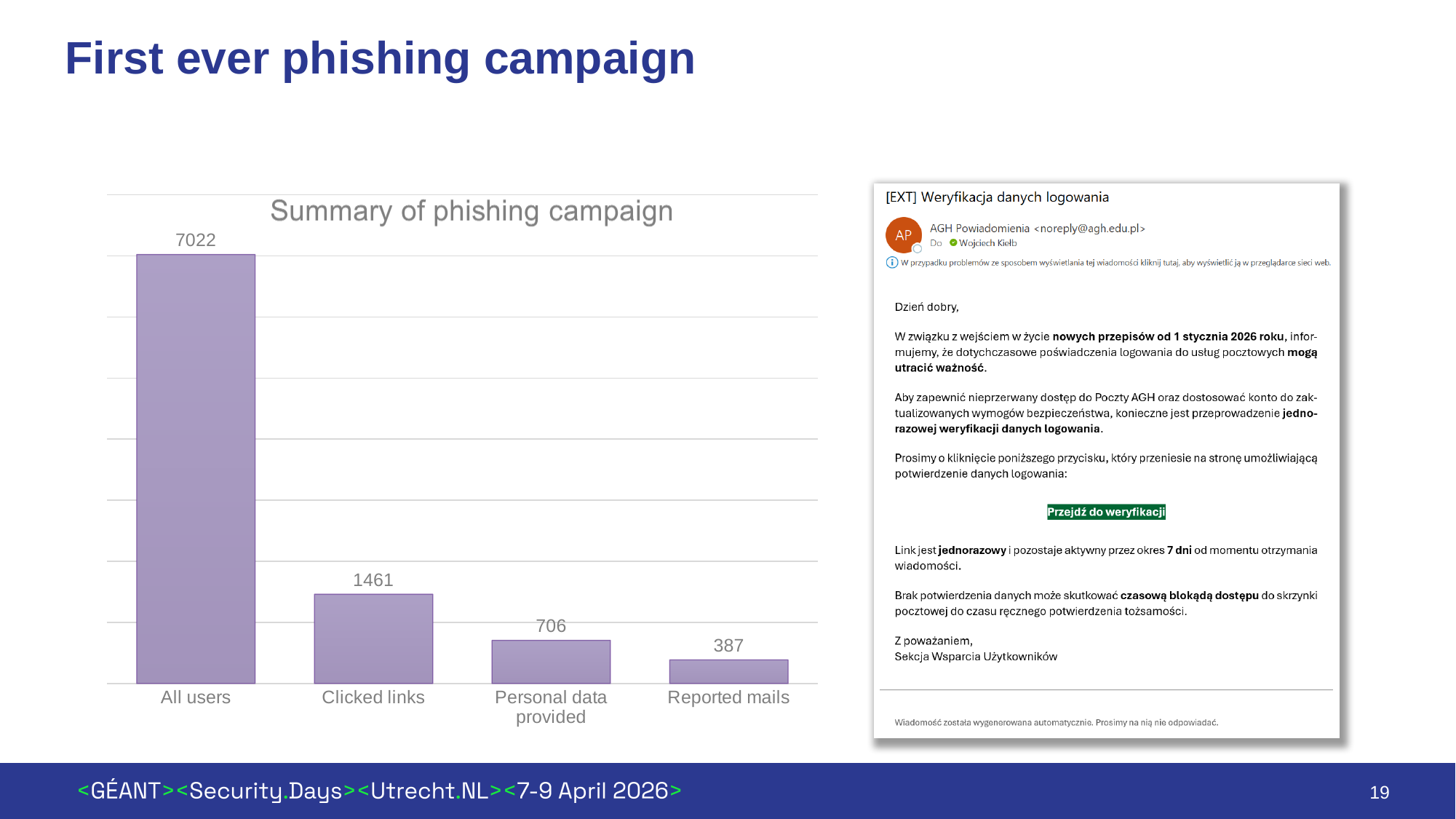
Do the values in the Summary of phishing campaign chart rise or fall from left to right? Fall Which category has the lowest value in the Summary of phishing campaign chart? Reported mails What is the value for Clicked links in the Summary of phishing campaign chart? 1461 How many categories are shown in the Summary of phishing campaign chart? 4 What is the value for Personal data provided in the Summary of phishing campaign chart? 706 What is the value for Reported mails in the Summary of phishing campaign chart? 387 What kind of chart is the Summary of phishing campaign chart? Bar chart What is the value for All users in the Summary of phishing campaign chart? 7022 What is the difference between Clicked links and Personal data provided in the Summary of phishing campaign chart? 755 What is the difference between Personal data provided and Reported mails in the Summary of phishing campaign chart? 319 Which category has the highest value in the Summary of phishing campaign chart? All users Which is larger in the Summary of phishing campaign chart: Clicked links or Reported mails? Clicked links